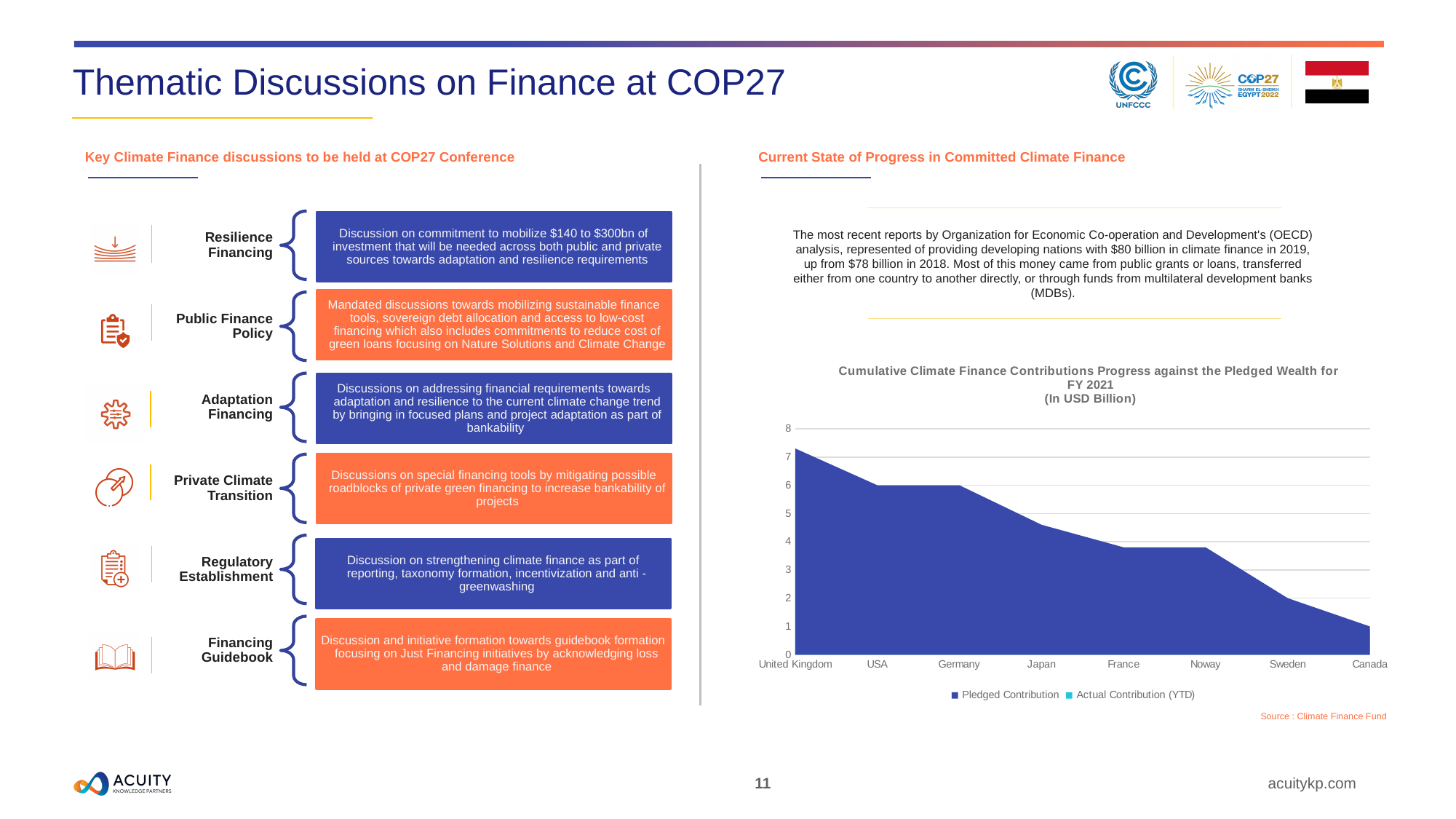
Is the pledged contribution for the United Kingdom greater or less than 7? greater In what unit are the values in the chart expressed, according to its title? USD Billion Which has a larger pledged contribution, Germany or Sweden? Germany How many countries are shown on the x axis of the chart? 8 Do the pledged contribution values rise or fall moving from United Kingdom to Canada along the x axis? Fall Which country has the lowest pledged contribution in the chart? Canada Is the pledged contribution for Japan greater or less than 4? greater Which country has the highest pledged contribution in the chart? United Kingdom Is the pledged contribution for France greater or less than 4? less How many series does the chart legend list? 2 What kind of chart is used to show the Cumulative Climate Finance Contributions Progress? Area chart